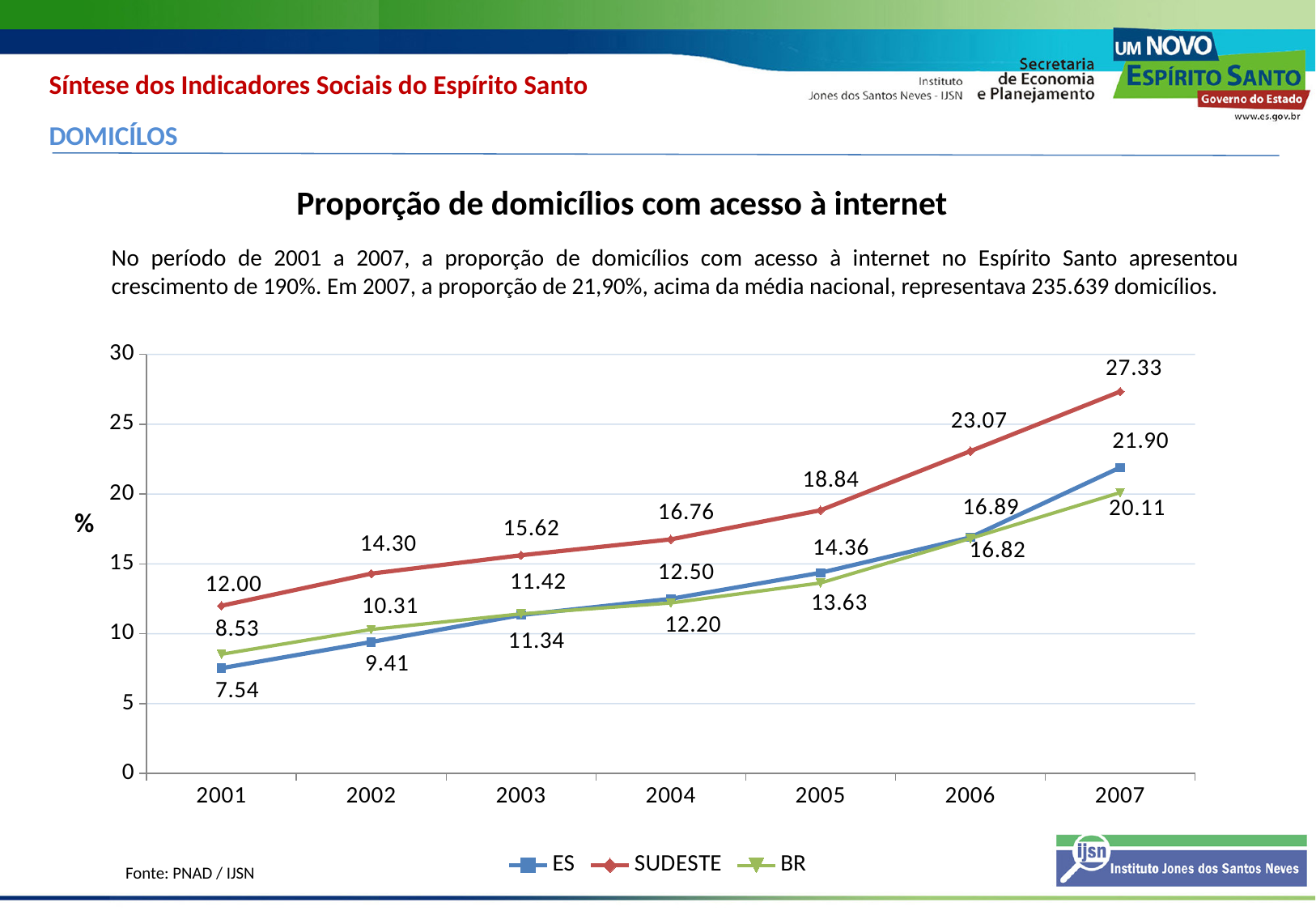
Which series has the highest value in 2007? SUDESTE Is the value for SUDESTE in 2006 greater or less than 20? greater What is the value for ES in 2001? 7.54 What is the difference between the SUDESTE and ES values in 2007? 5.43 In 2007, which is larger: the value for ES or the value for BR? ES In which year does the ES series have its lowest value? 2001 What is the value for SUDESTE in 2007? 27.33 How many series does the legend list? 3 Does the ES series rise or fall from 2001 to 2007? rises How many years are shown on the x axis? 7 What kind of chart is shown on the slide? line chart What is the value for BR in 2005? 13.63